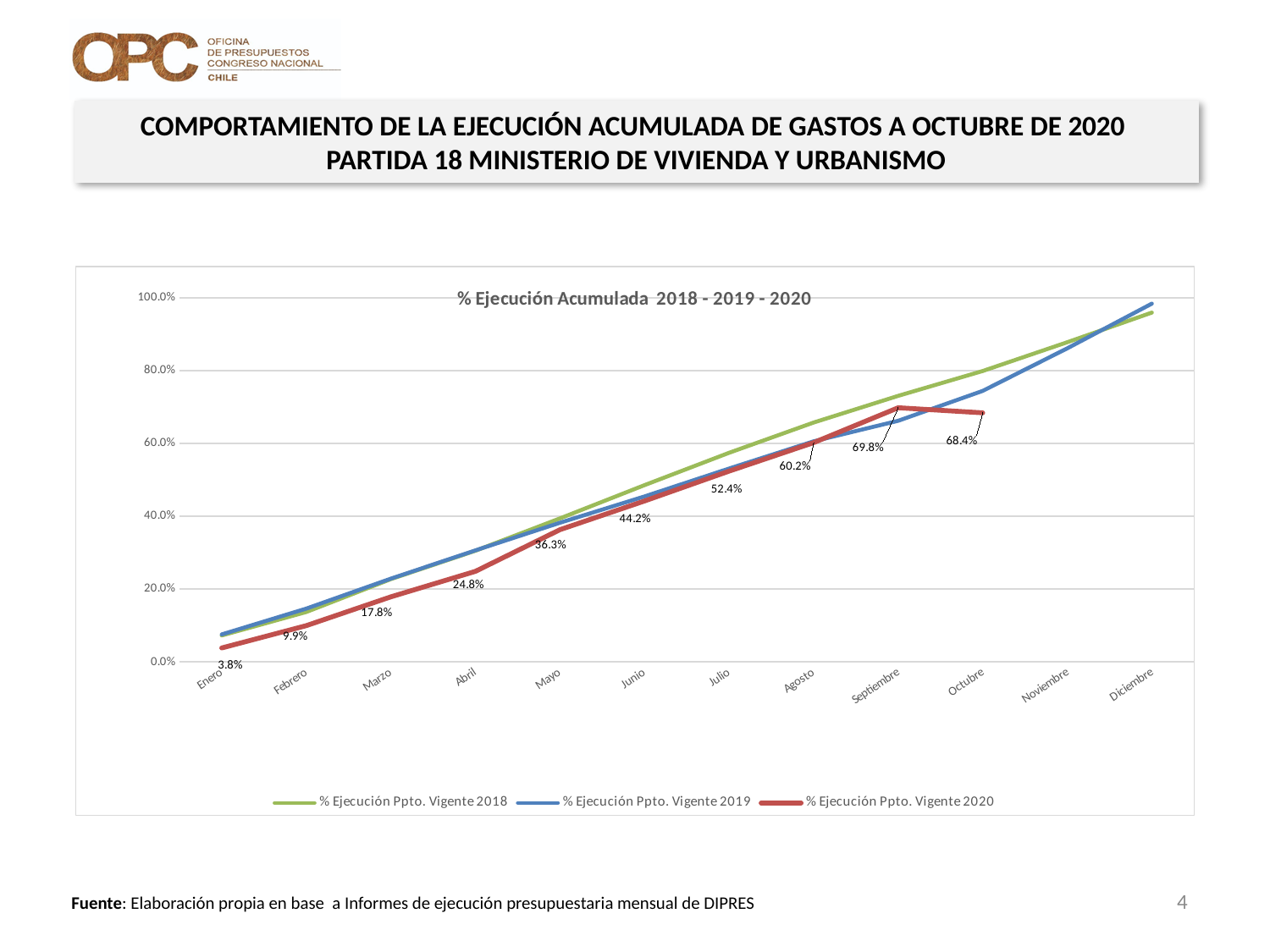
What is the value of % Ejecución Ppto. Vigente 2020 for Enero? 3.8% How many series does the chart legend list? 3 Which month has the lowest value for % Ejecución Ppto. Vigente 2020? Enero How many months are shown on the x axis? 12 What is the difference between the % Ejecución Ppto. Vigente 2020 values for Septiembre and Octubre? 1.4% What is the value of % Ejecución Ppto. Vigente 2020 for Mayo? 36.3% Is the % Ejecución Ppto. Vigente 2020 value for Julio greater or less than 60.0%? less Which month has the highest value for % Ejecución Ppto. Vigente 2020? Septiembre What is the title of the chart? % Ejecución Acumulada 2018 - 2019 - 2020 What is the value of % Ejecución Ppto. Vigente 2020 for Septiembre? 69.8% What is the value of % Ejecución Ppto. Vigente 2020 for Octubre? 68.4% What type of chart is shown on the slide? line chart